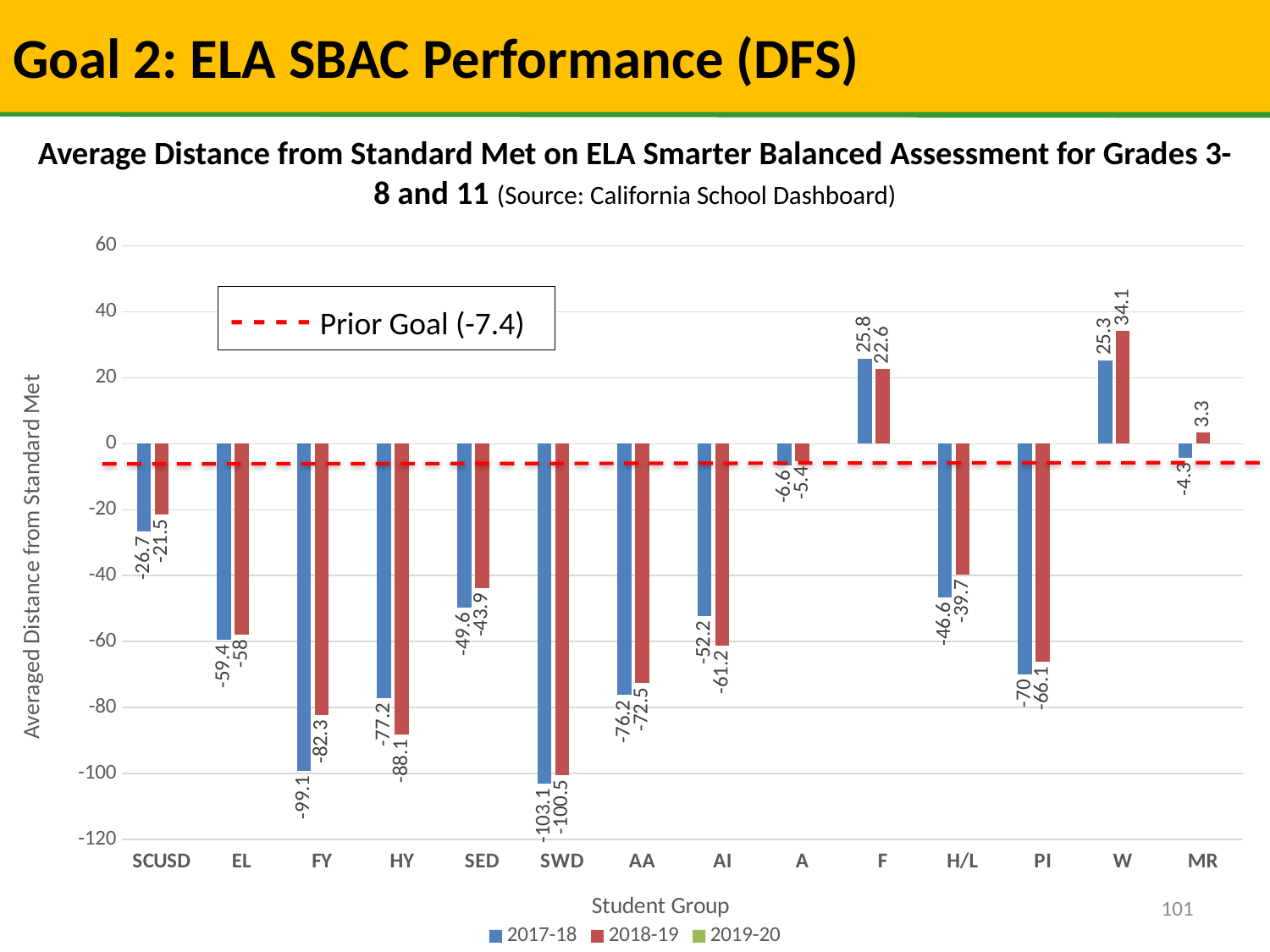
Which student group has the lowest 2017-18 value? SWD What kind of chart is shown on the slide? Bar chart What is the 2018-19 value for MR? 3.3 What is the difference between the 2018-19 and 2017-18 values for W? 8.8 What is the 2018-19 value for SWD? -100.5 What value does the dashed Prior Goal line represent? -7.4 What is the difference between the 2018-19 and 2017-18 values for FY? 16.8 How many student groups are shown on the x axis? 14 Which student group has the highest 2018-19 value? W For HY, which series has the higher value, 2017-18 or 2018-19? 2017-18 How many series does the legend list? 3 What is the 2017-18 value for F? 25.8